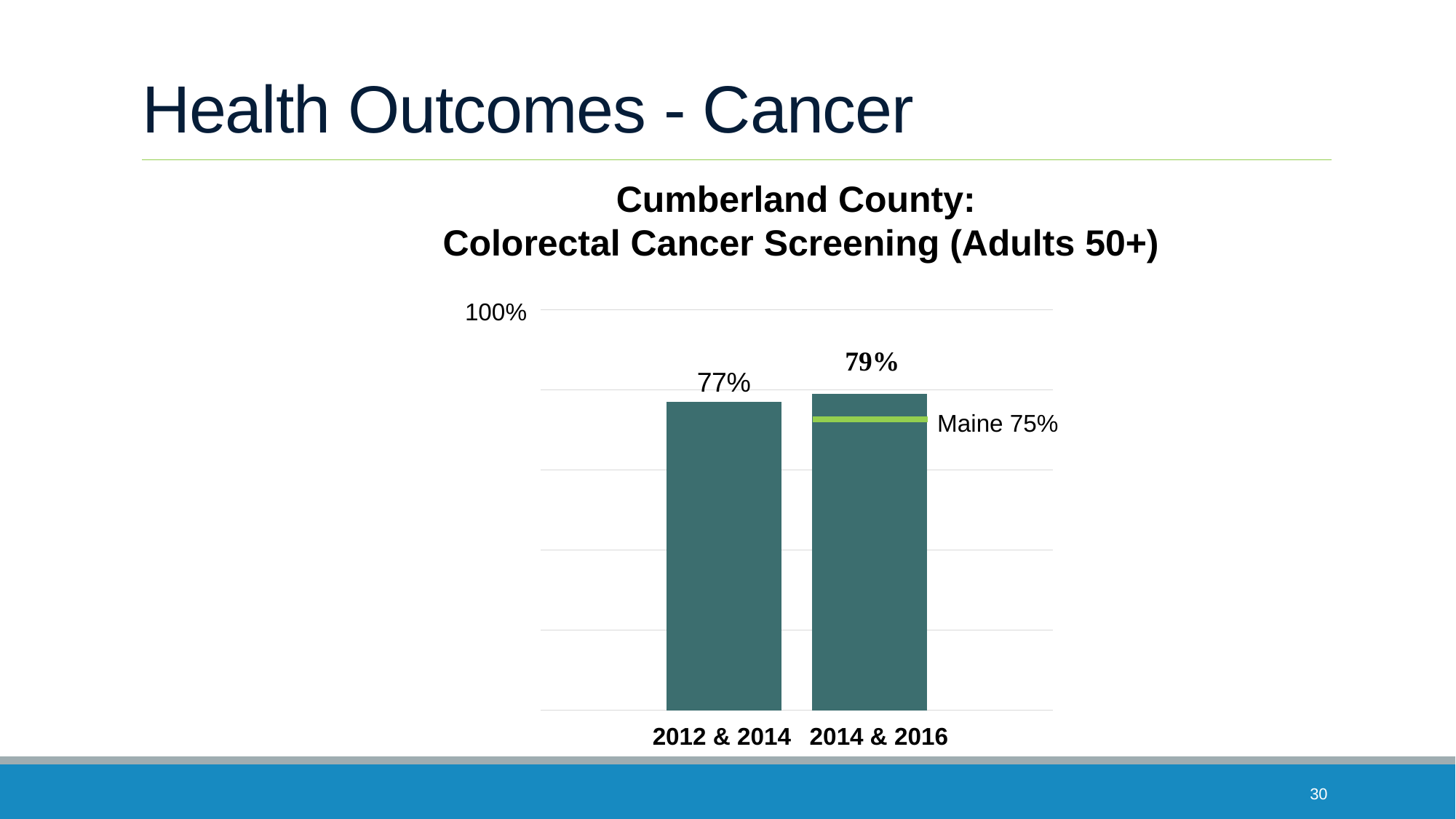
What is the Maine reference value shown on the chart? 75% What is the colorectal cancer screening rate for 2012 & 2014? 77% How many bars are shown on the chart? 2 What is the difference between the 2014 & 2016 rate and the 2012 & 2014 rate? 2% What is the colorectal cancer screening rate for 2014 & 2016? 79% Do the screening rates rise or fall from 2012 & 2014 to 2014 & 2016? rise Is the 2012 & 2014 value greater or less than the Maine 75% line? greater How much higher is the 2014 & 2016 rate than the Maine value? 4% Which period has the higher screening rate? 2014 & 2016 What kind of chart is shown? bar chart Which period has the lower screening rate? 2012 & 2014 What is the title of the chart? Cumberland County: Colorectal Cancer Screening (Adults 50+)